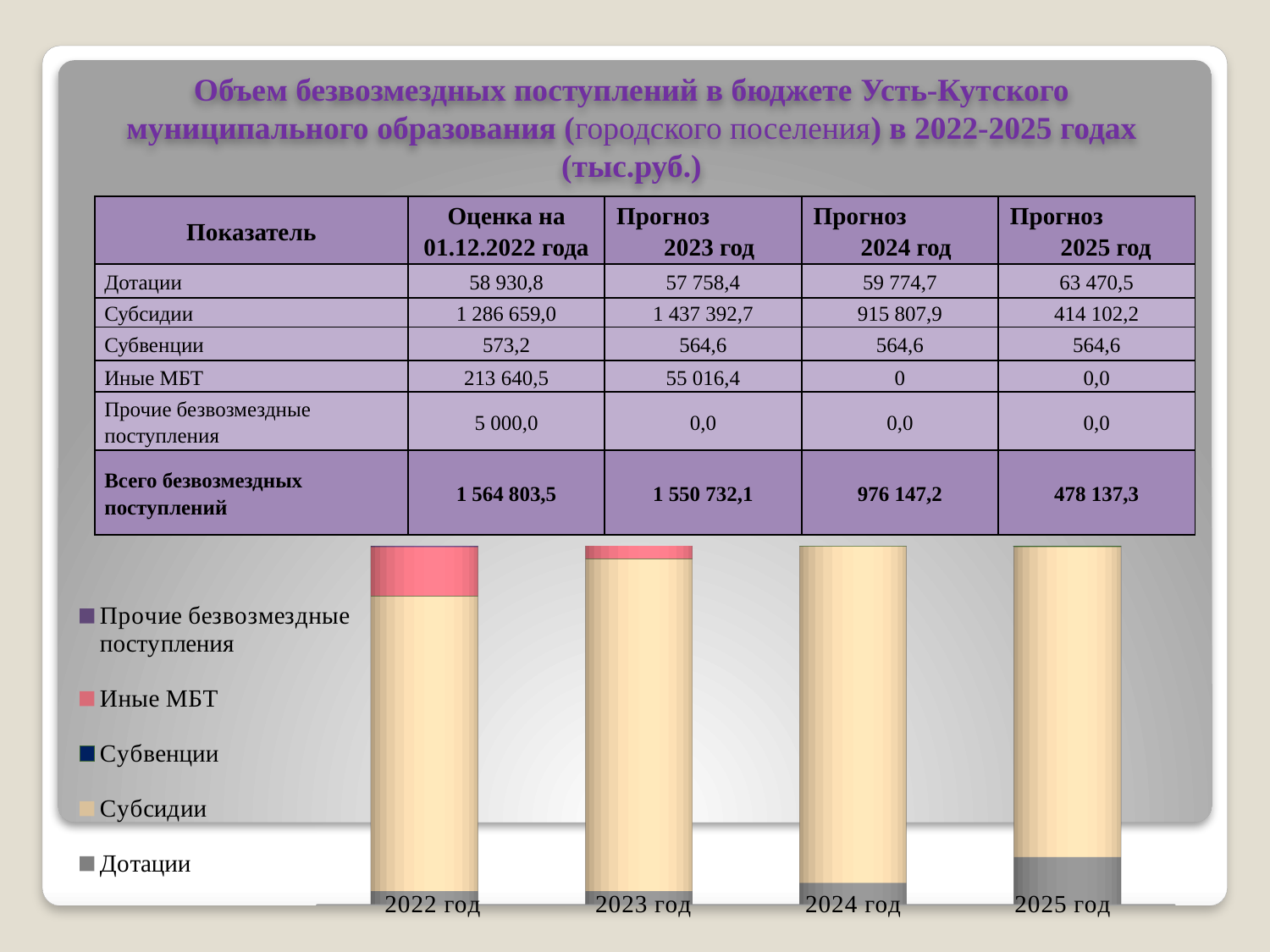
Which series is listed first (at the top) of the chart legend? Прочие безвозмездные поступления In the 2022 год bar, which segment is larger: Иные МБТ or Дотации? Иные МБТ How many bars (years) does the chart show? 4 What kind of chart is shown at the bottom of the slide? Stacked bar chart In which year's bar is the Иные МБТ segment the largest? 2022 год Which series forms the largest segment in every bar of the chart? Субсидии Is the Дотации segment larger in the 2022 год bar or the 2025 год bar? 2025 год In which year's bar is the Дотации segment the largest? 2025 год Which series is shown in pink in the chart? Иные МБТ Does the share of Дотации in the bars rise or fall from 2022 год to 2025 год? Rise Does the share of Иные МБТ in the bars rise or fall from 2022 год to 2023 год? Fall How many series does the chart legend list? 5